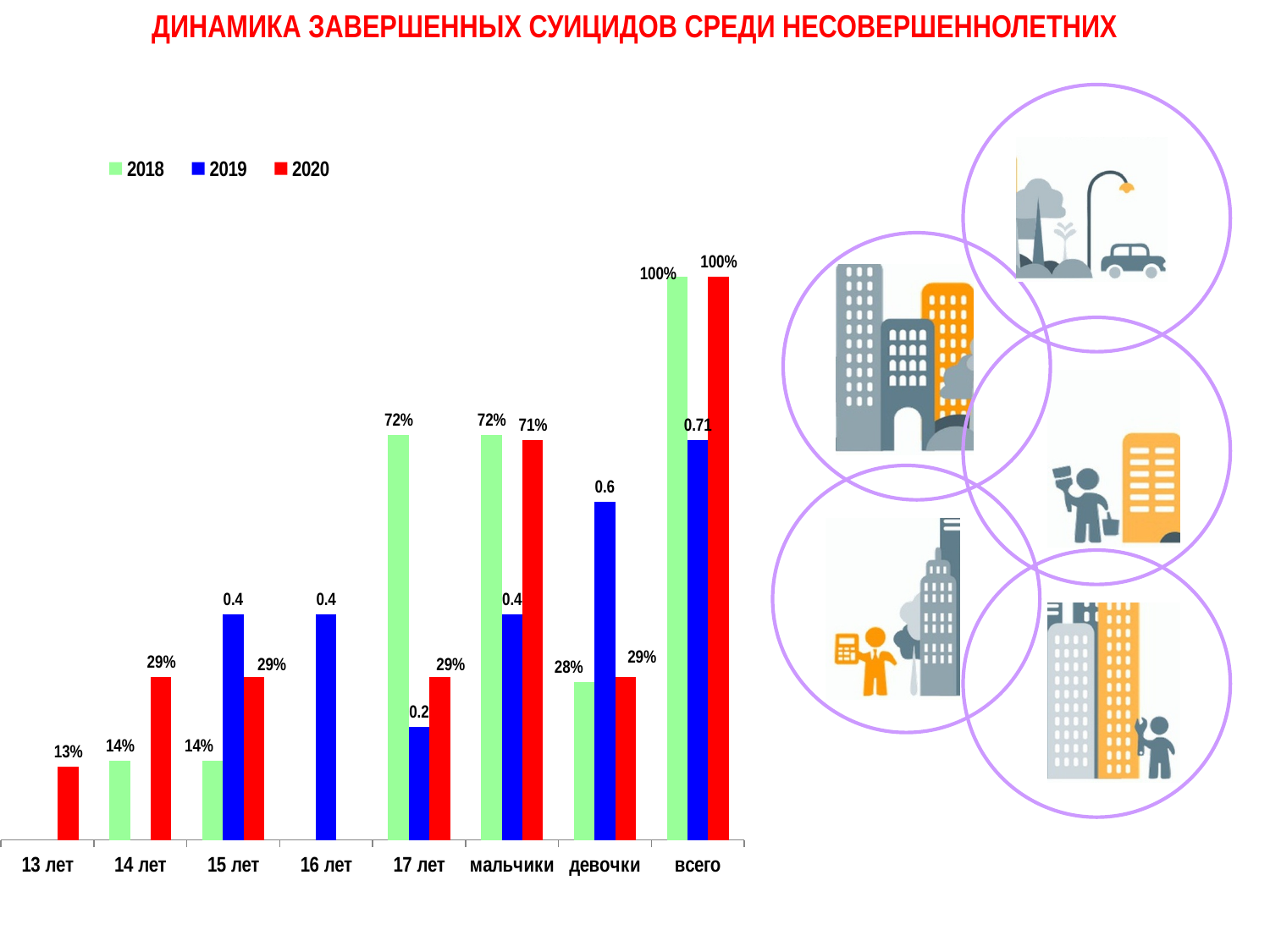
What is the value for 2020 in the 13 лет category? 13% What is the value for 2019 in the девочки category? 0.6 Which is larger for the 2019 series: the value for девочки or the value for мальчики? девочки Which category has the lowest value for the 2019 series? 17 лет What is the difference between the 2018 and 2020 values for 17 лет? 43% What is the value for 2018 in the 17 лет category? 72% Which category has the lowest value for the 2020 series? 13 лет What is the value for 2019 in the всего category? 0.71 How many categories are shown on the x axis? 8 What is the difference between the 2020 values for мальчики and девочки? 42% What type of chart is shown on the slide? bar chart How many series does the legend list? 3